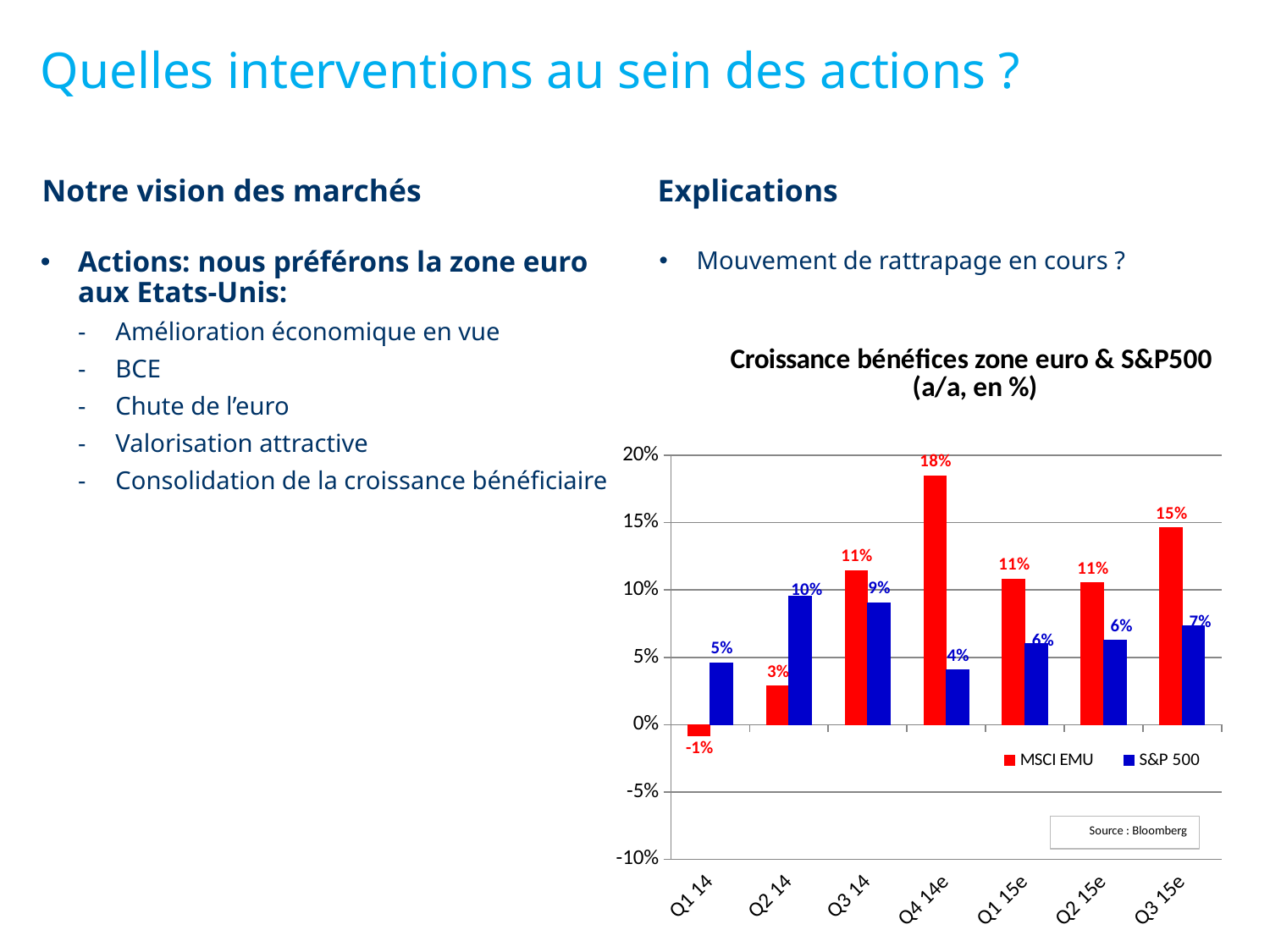
In which quarter is the MSCI EMU value highest? Q4 14e In Q1 14, which series has the larger value, MSCI EMU or S&P 500? S&P 500 In which quarter is the S&P 500 value lowest? Q4 14e What is the MSCI EMU value for Q1 14? -1% What is the MSCI EMU value for Q4 14e? 18% What is the difference between the MSCI EMU and S&P 500 values in Q4 14e? 14% What is the S&P 500 value for Q2 14? 10% How many quarters are shown on the x axis? 7 How many series does the legend list? 2 What kind of chart is shown on the slide? bar chart Is the MSCI EMU value for Q3 15e greater or less than 10%? greater What is the S&P 500 value for Q3 15e? 7%